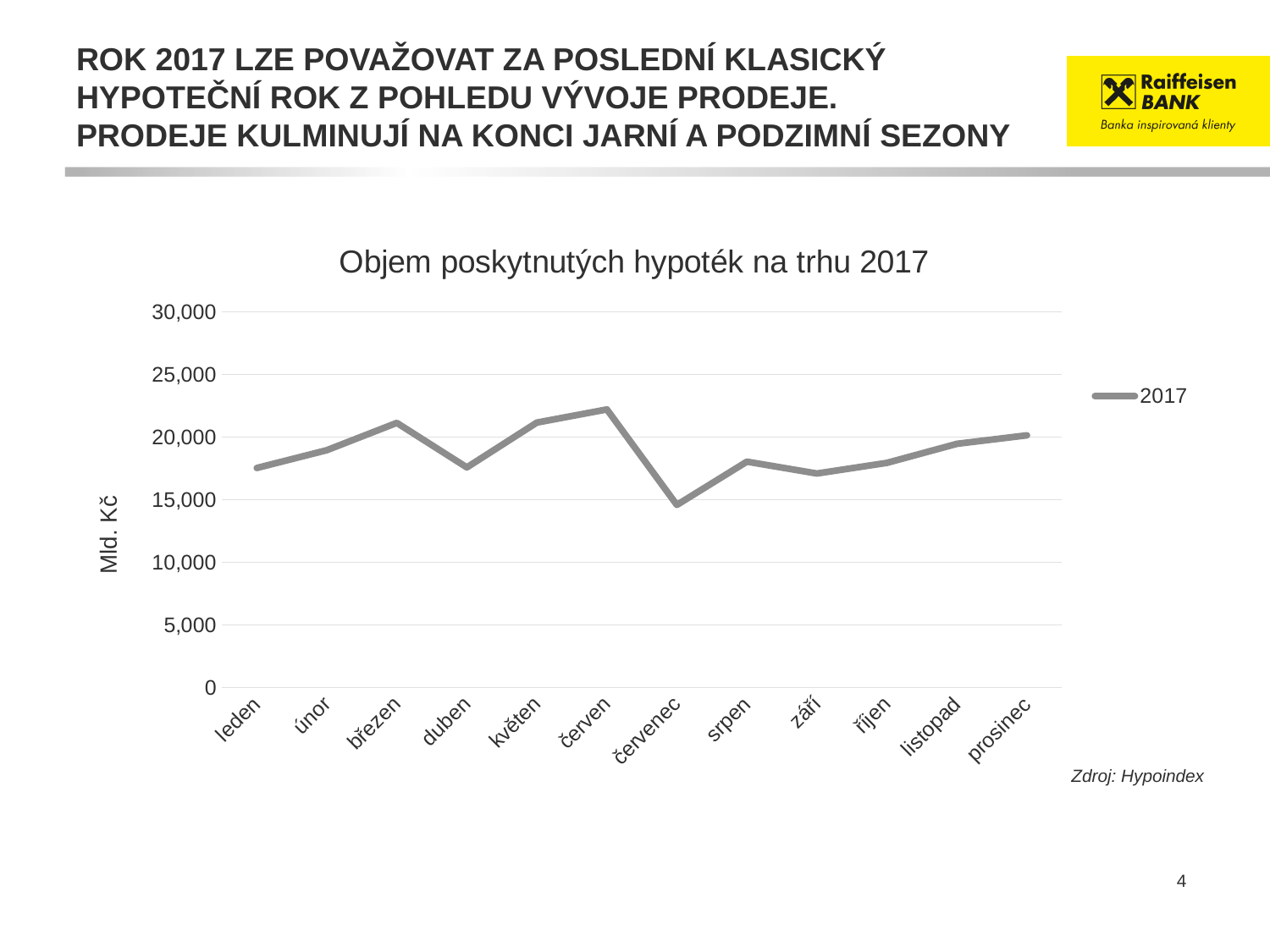
What is the title of the chart? Objem poskytnutých hypoték na trhu 2017 What kind of chart is shown on the slide? line chart How many series does the legend list? 1 Which is larger, the value for březen or the value for duben? březen Does the line rise or fall from červen to červenec? fall Is the value for duben greater or less than 20,000? less What is the label on the y axis? Mld. Kč Which month has the highest value? červen How many months (data points) are plotted along the x axis? 12 Which month has the lowest value? červenec Is the value for červen greater or less than 20,000? greater